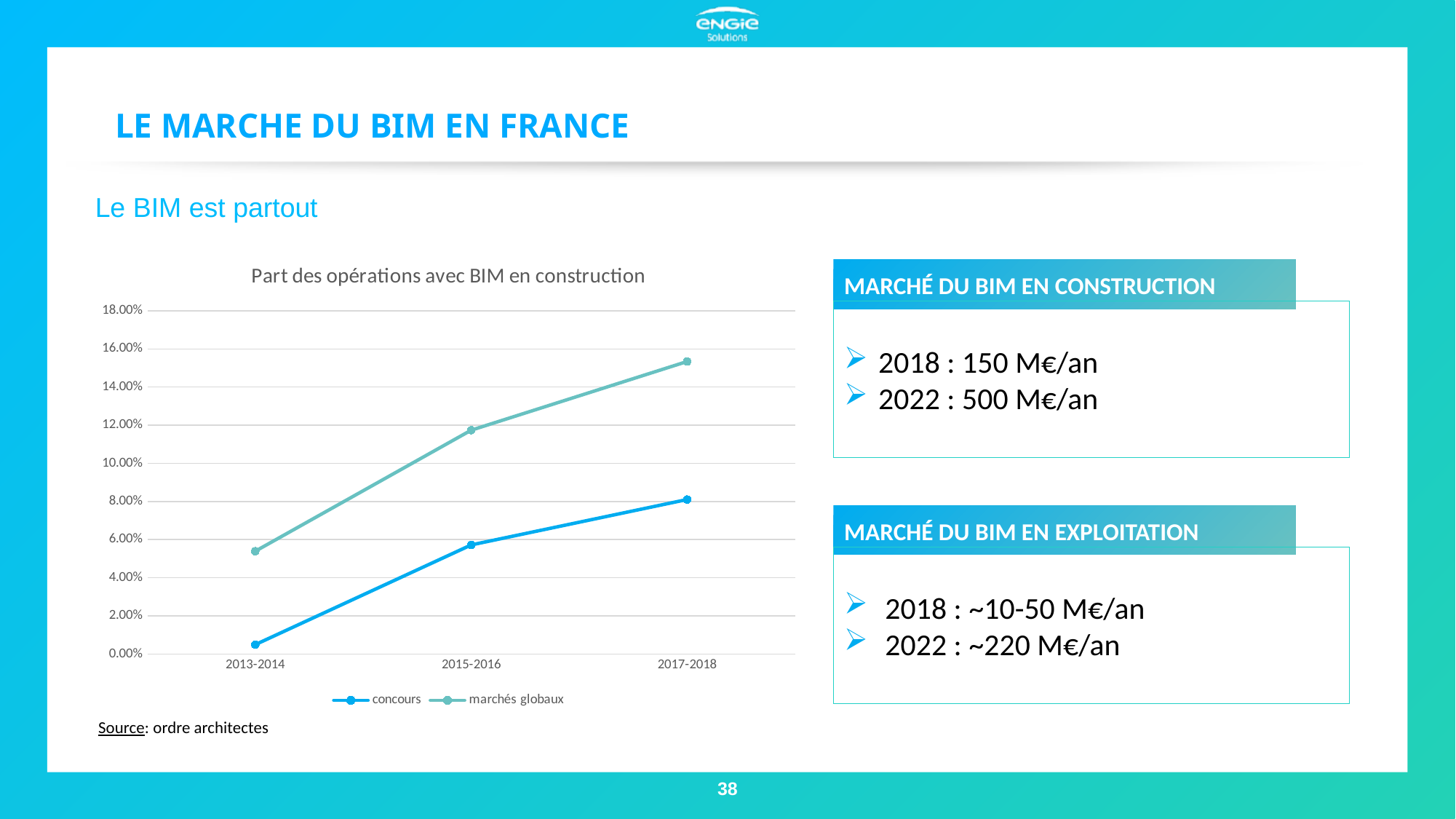
What kind of chart is shown on the slide? line chart In which period is the concours series at its lowest? 2013-2014 What is the title of the chart? Part des opérations avec BIM en construction How many periods are shown on the x axis of the chart? 3 Which two series are listed in the chart legend? concours and marchés globaux Is the value for marchés globaux in 2015-2016 greater or less than 10.00%? greater In which period is the marchés globaux series at its highest? 2017-2018 Is the value for concours in 2013-2014 greater or less than 2.00%? less How many series does the chart legend list? 2 In 2017-2018, which series has the larger value, concours or marchés globaux? marchés globaux Is the value for marchés globaux in 2017-2018 greater or less than 14.00%? greater Do the values for the concours series rise or fall from 2013-2014 to 2017-2018? rise